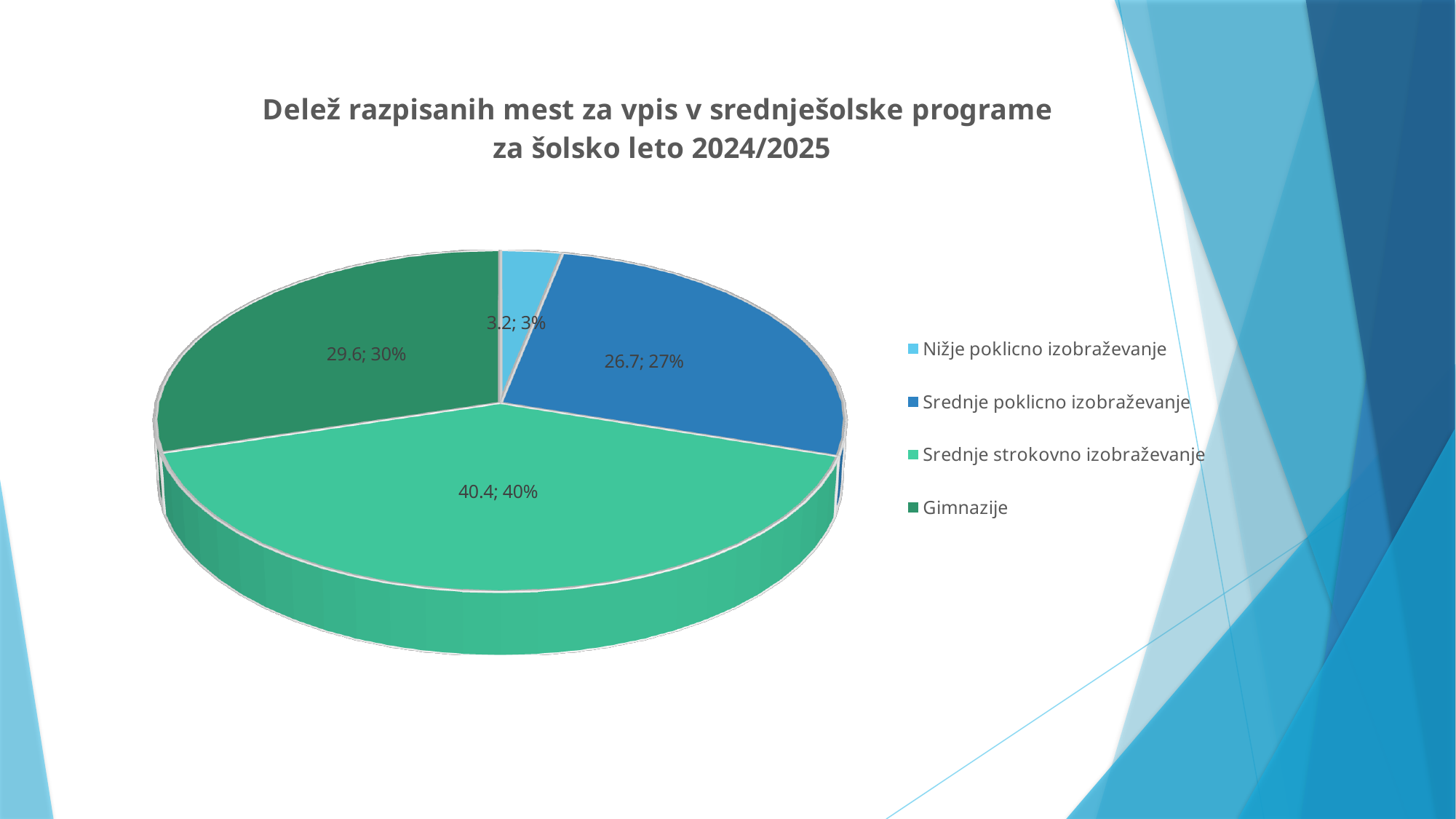
What kind of chart is shown on the slide? pie chart What is the title of the chart? Delež razpisanih mest za vpis v srednješolske programe za šolsko leto 2024/2025 What is the value for Nižje poklicno izobraževanje? 3.2 What is the value for Srednje poklicno izobraževanje? 26.7 How many categories does the pie chart have? 4 What percentage share of the pie does Gimnazije have? 30% What is the value for Gimnazije? 29.6 Which is larger, the value for Gimnazije or the value for Srednje poklicno izobraževanje? Gimnazije What percentage share of the pie does Srednje strokovno izobraževanje have? 40% Which category has the smallest slice? Nižje poklicno izobraževanje Which category has the largest slice? Srednje strokovno izobraževanje What is the difference between the values for Srednje strokovno izobraževanje and Gimnazije? 10.8